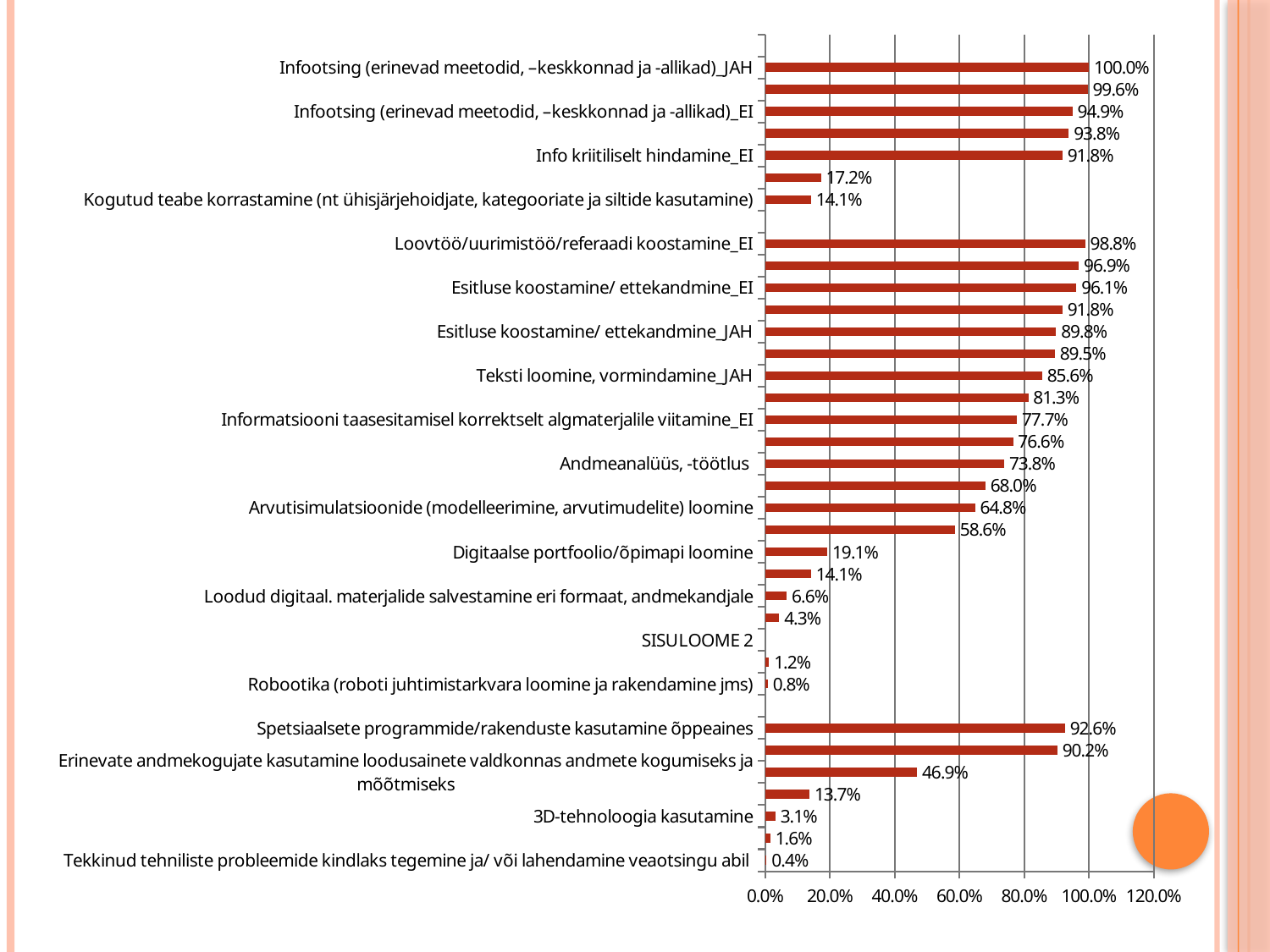
Which labelled category has the highest value? Infootsing (erinevad meetodid, –keskkonnad ja -allikad)_JAH What is the value for "Spetsiaalsete programmide/rakenduste kasutamine õppeaines"? 92.6% Which is larger: "Loovtöö/uurimistöö/referaadi koostamine_EI" or "Teksti loomine, vormindamine_JAH"? Loovtöö/uurimistöö/referaadi koostamine_EI What type of chart is shown on the slide? bar chart What is the value for "Digitaalse portfoolio/õpimapi loomine"? 19.1% What is the value for "Andmeanalüüs, -töötlus"? 73.8% What is the value for "Infootsing (erinevad meetodid, –keskkonnad ja -allikad)_JAH"? 100.0% Which labelled category has the lowest value? Tekkinud tehniliste probleemide kindlaks tegemine ja/ või lahendamine veaotsingu abil What is the highest tick value shown on the horizontal axis? 120.0% What is the value for "3D-tehnoloogia kasutamine"? 3.1% What is the difference between "Esitluse koostamine/ ettekandmine_EI" and "Esitluse koostamine/ ettekandmine_JAH"? 6.3 percentage points Is the value for "Arvutisimulatsioonide (modelleerimine, arvutimudelite) loomine" greater or less than 60.0%? greater